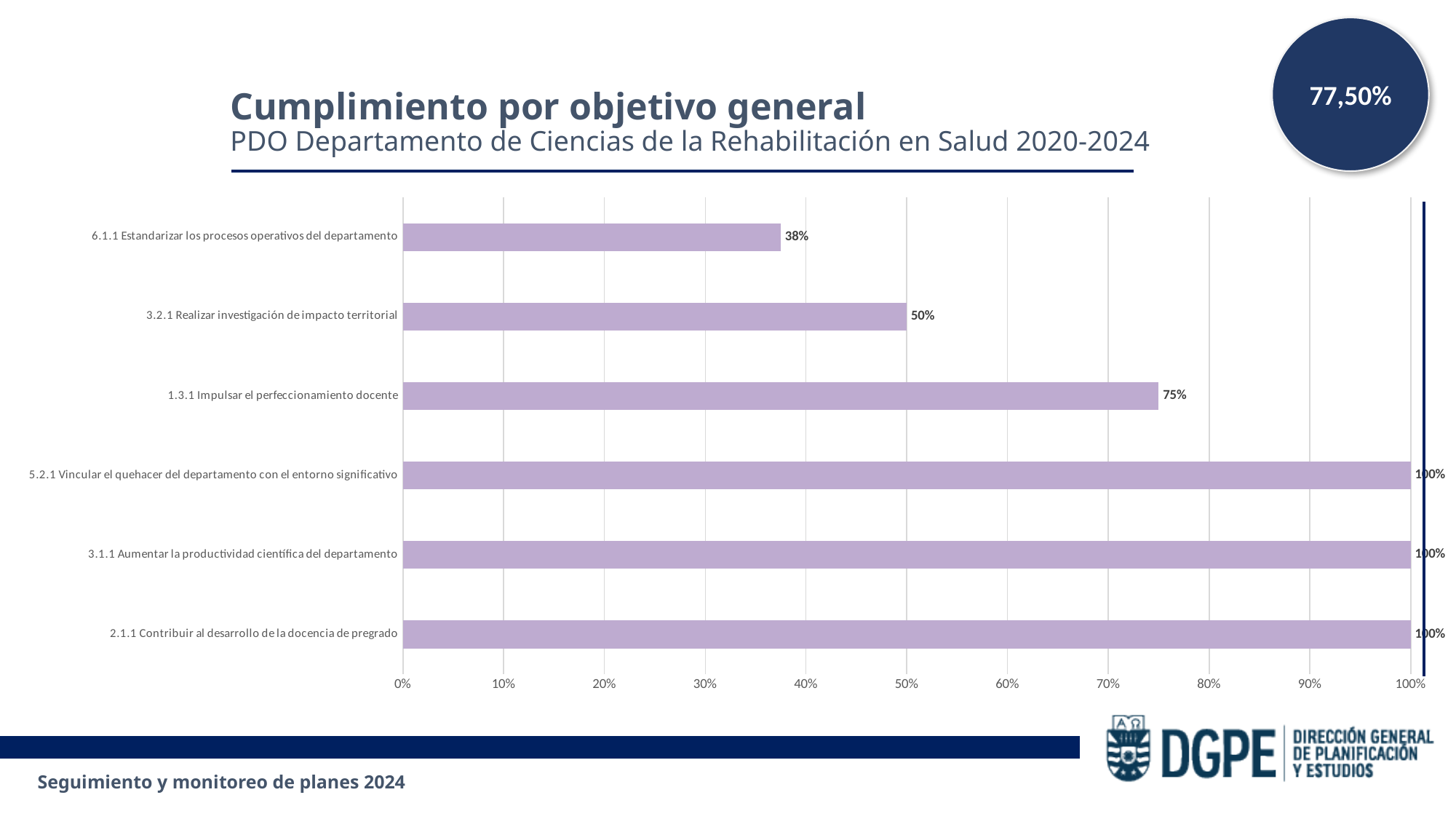
What kind of chart is shown on the slide? Bar chart What is the value for '2.1.1 Contribuir al desarrollo de la docencia de pregrado'? 100% What is the value for '1.3.1 Impulsar el perfeccionamiento docente'? 75% What is the value for '6.1.1 Estandarizar los procesos operativos del departamento'? 38% What is the value for '3.2.1 Realizar investigación de impacto territorial'? 50% Which category has the lowest value? 6.1.1 Estandarizar los procesos operativos del departamento What is the difference between the values for '1.3.1 Impulsar el perfeccionamiento docente' and '6.1.1 Estandarizar los procesos operativos del departamento'? 37% Which is larger: the value for '3.2.1 Realizar investigación de impacto territorial' or '1.3.1 Impulsar el perfeccionamiento docente'? 1.3.1 Impulsar el perfeccionamiento docente What overall percentage is shown in the circle at the top right of the slide? 77,50% How many categories are shown in the chart? 6 How many categories have a value of 100%? 3 What is the difference between the values for '5.2.1 Vincular el quehacer del departamento con el entorno significativo' and '3.2.1 Realizar investigación de impacto territorial'? 50%